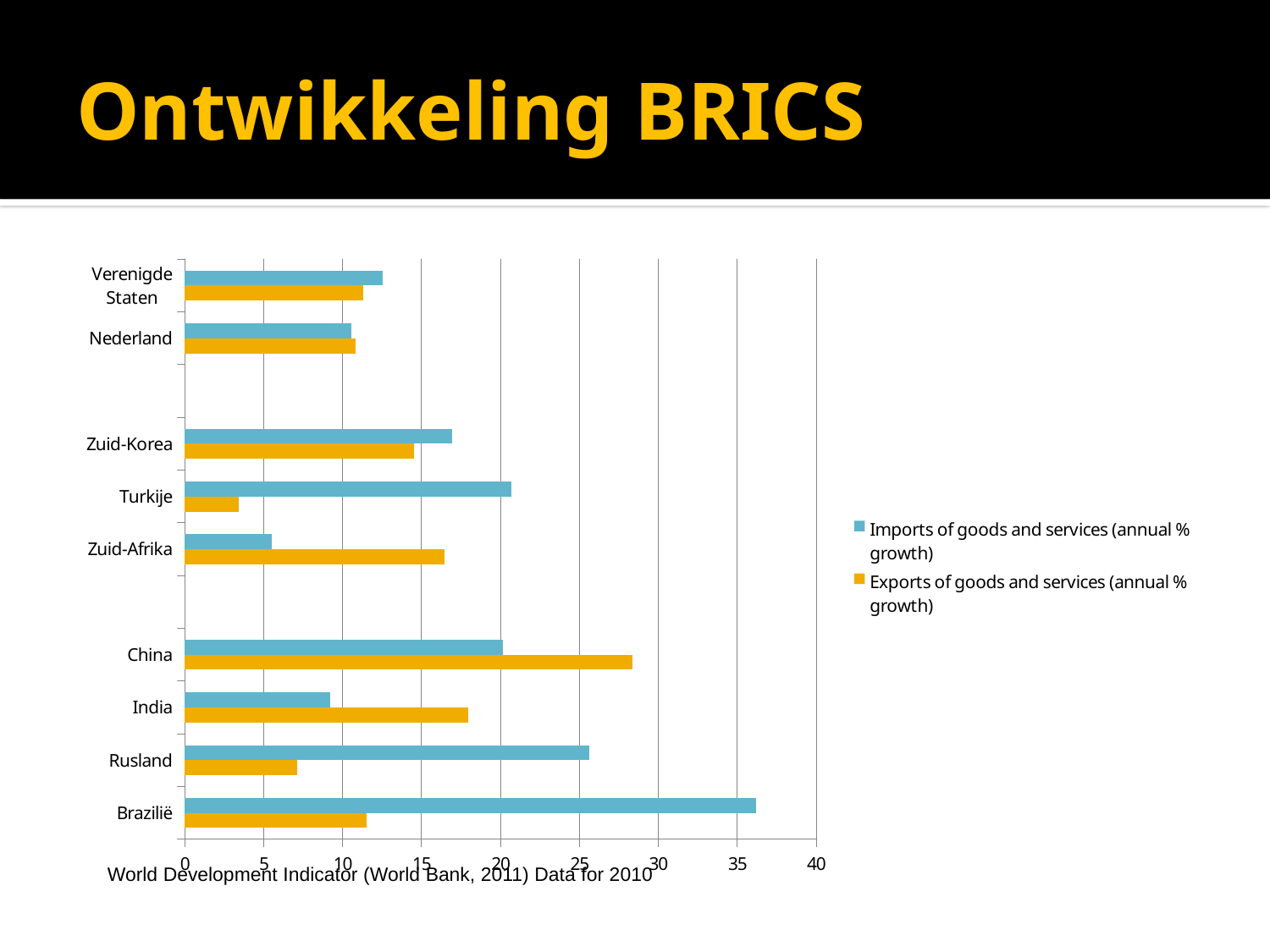
Which country has the highest value for Exports of goods and services (annual % growth)? China Is the Imports of goods and services value for Brazilië greater or less than 35? greater Is the Exports of goods and services value for China greater or less than 25? greater Which colour represents Exports of goods and services (annual % growth) in the chart? orange How many series does the legend list? 2 Which country has the lowest value for Imports of goods and services (annual % growth)? Zuid-Afrika How many countries are labelled on the vertical axis of the chart? 9 Is the Exports of goods and services value for Turkije greater or less than 5? less Which country has the highest value for Imports of goods and services (annual % growth)? Brazilië What kind of chart is shown on the slide? bar chart Which country has the lowest value for Exports of goods and services (annual % growth)? Turkije For Rusland, which is larger: Imports of goods and services or Exports of goods and services? Imports of goods and services